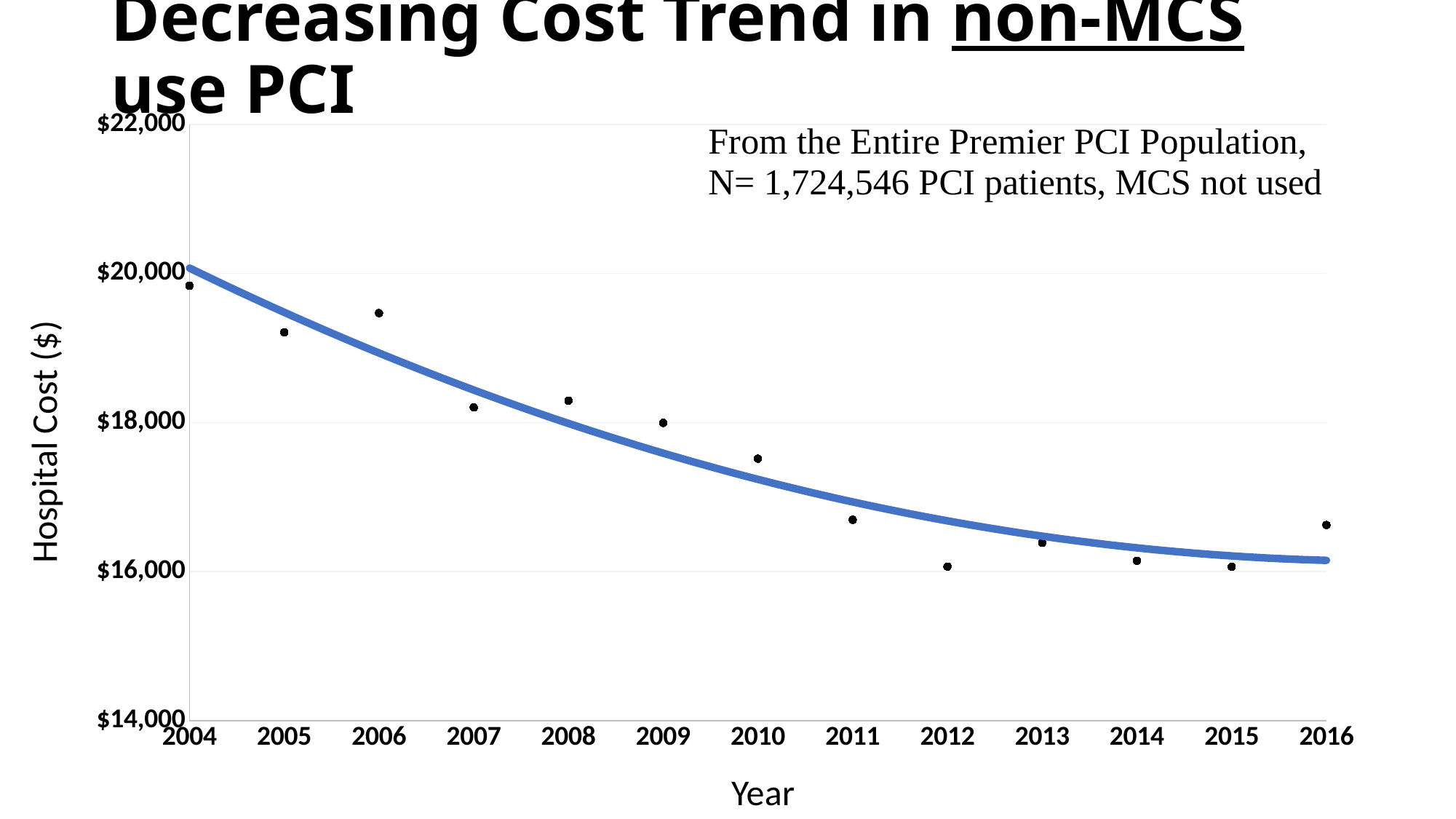
Which year has the highest hospital cost? 2004 What is the label of the y axis? Hospital Cost ($) Is the hospital cost for 2006 greater or less than $20,000? less Which year has the higher hospital cost, 2008 or 2010? 2008 Which year has the higher hospital cost, 2004 or 2016? 2004 How many years (data points) are plotted along the x axis? 13 Is the hospital cost for 2011 greater or less than $16,000? greater Do the hospital cost values rise or fall from 2004 to 2016? Fall What kind of chart is shown on the slide? Scatter chart with a trend line Is the hospital cost for 2004 greater or less than $18,000? greater According to the annotation on the chart, how many PCI patients are in the population? 1,724,546